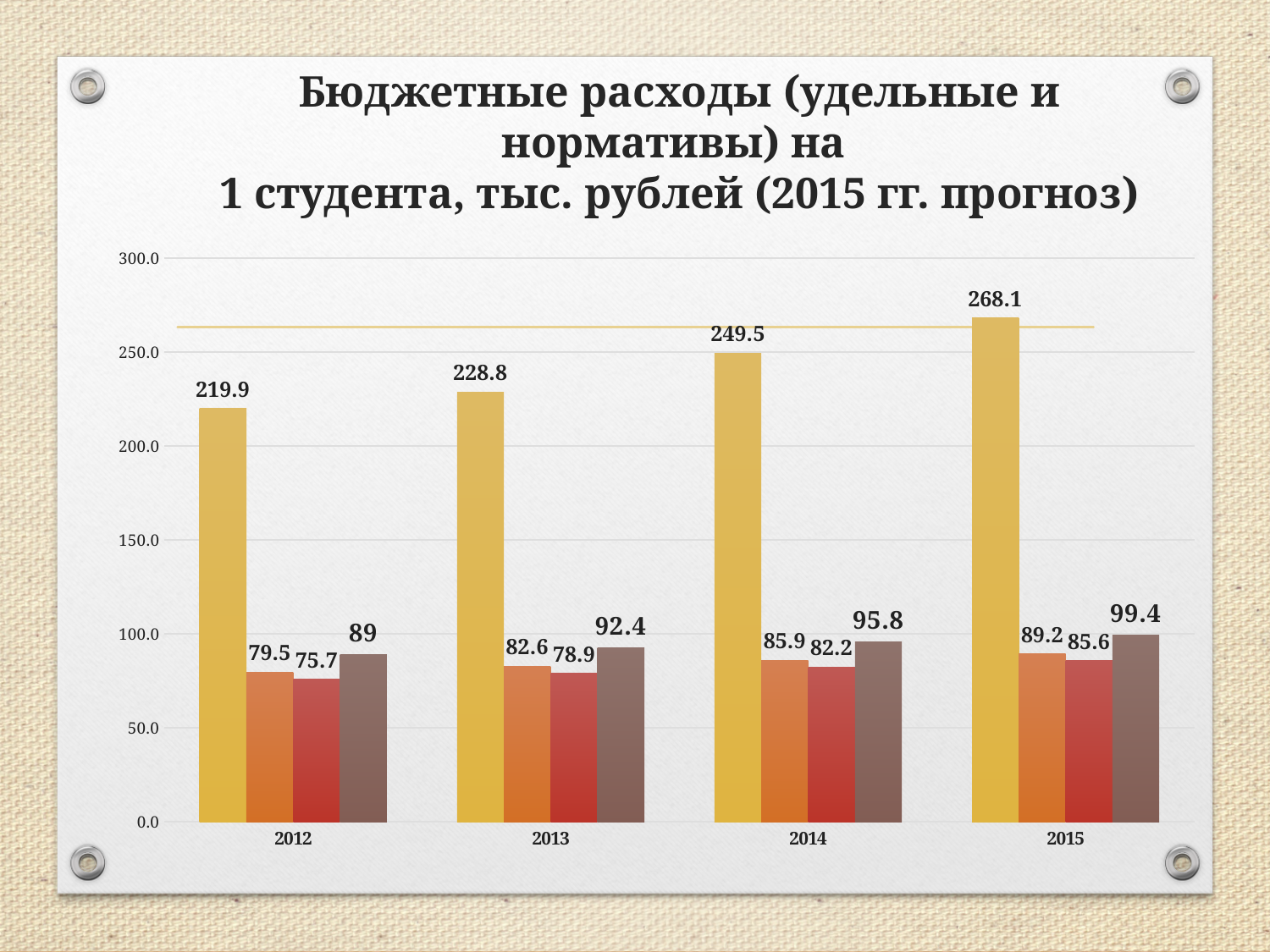
What type of chart is shown on the slide? bar chart In which year is the yellow bar highest? 2015 What is the value of the red bar for 2012? 75.7 What is the value of the yellow bar for 2014? 249.5 What is the value of the orange bar for 2015? 89.2 In which year is the brown bar lowest? 2012 What is the difference between the yellow bar values for 2015 and 2012? 48.2 What is the value of the brown bar for 2013? 92.4 Which is larger for 2014: the orange bar or the red bar? the orange bar How many bars are shown for each year? 4 Do the yellow bar values rise or fall from 2012 to 2015? rise How many years are shown on the x axis of the chart? 4